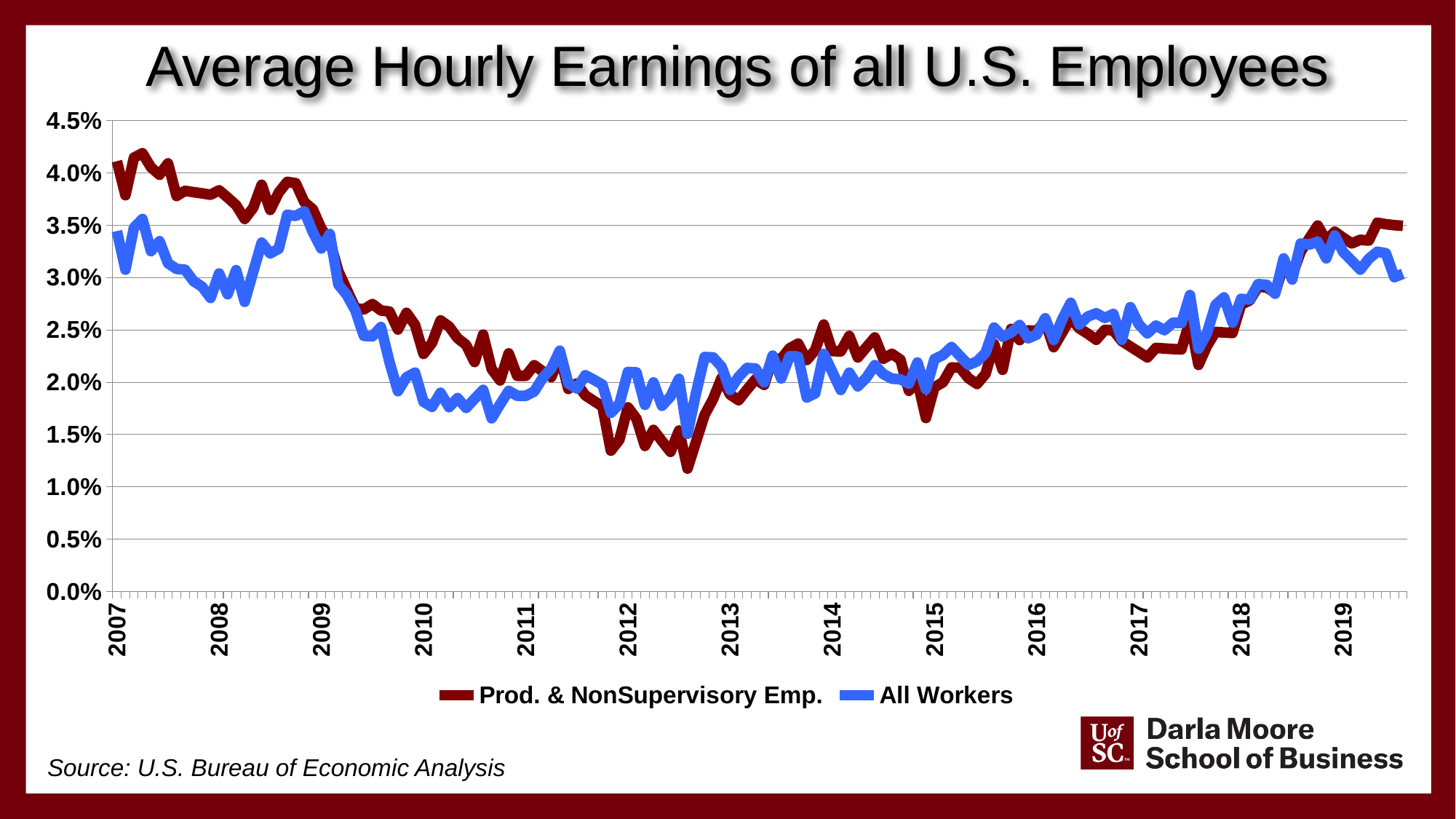
Do the values for All Workers generally rise or fall from 2012 to 2019? rise What is the title of the chart? Average Hourly Earnings of all U.S. Employees Which series is drawn in blue? All Workers Do the values for Prod. & NonSupervisory Emp. generally rise or fall from 2007 to 2012? fall How many series does the legend list? 2 Is the lowest value of the All Workers line, reached around 2012, greater or less than 2.0%? less How many year labels are shown on the x axis? 13 What kind of chart is shown on the slide? Line chart Is the lowest value of the Prod. & NonSupervisory Emp. line, reached around 2012, greater or less than 1.5%? less At the start of 2007, which series is higher: Prod. & NonSupervisory Emp. or All Workers? Prod. & NonSupervisory Emp. Is the value for Prod. & NonSupervisory Emp. at the start of 2007 greater or less than 3.5%? greater Around the start of 2010, which series is lower: Prod. & NonSupervisory Emp. or All Workers? All Workers